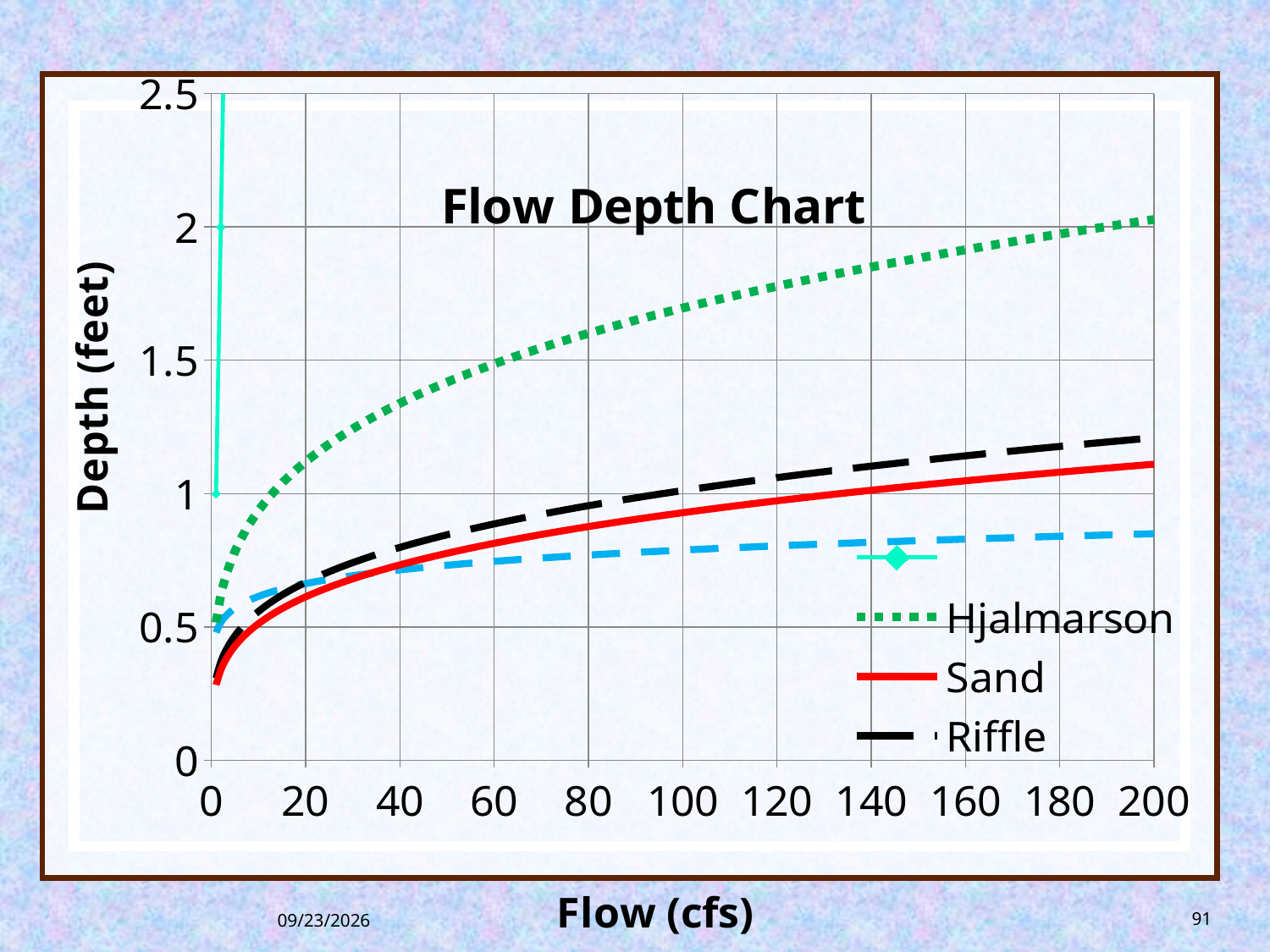
Do the depth values rise or fall as flow increases along the x axis? rise What is the label of the y axis? Depth (feet) What is the title of the chart? Flow Depth Chart Is the Sand depth at a flow of 100 cfs greater or less than 1 foot? less What kind of chart is shown on the slide? line chart Which of the legend series has the lowest depth at a flow of 200 cfs? Sand Is the Hjalmarson depth at a flow of 40 cfs greater or less than 1 foot? greater Is the Hjalmarson depth at a flow of 100 cfs greater or less than 1.5 feet? greater How many series does the chart legend list? 3 Which series has the highest depth at a flow of 200 cfs? Hjalmarson At a flow of 200 cfs, which series has the greater depth, Riffle or Sand? Riffle